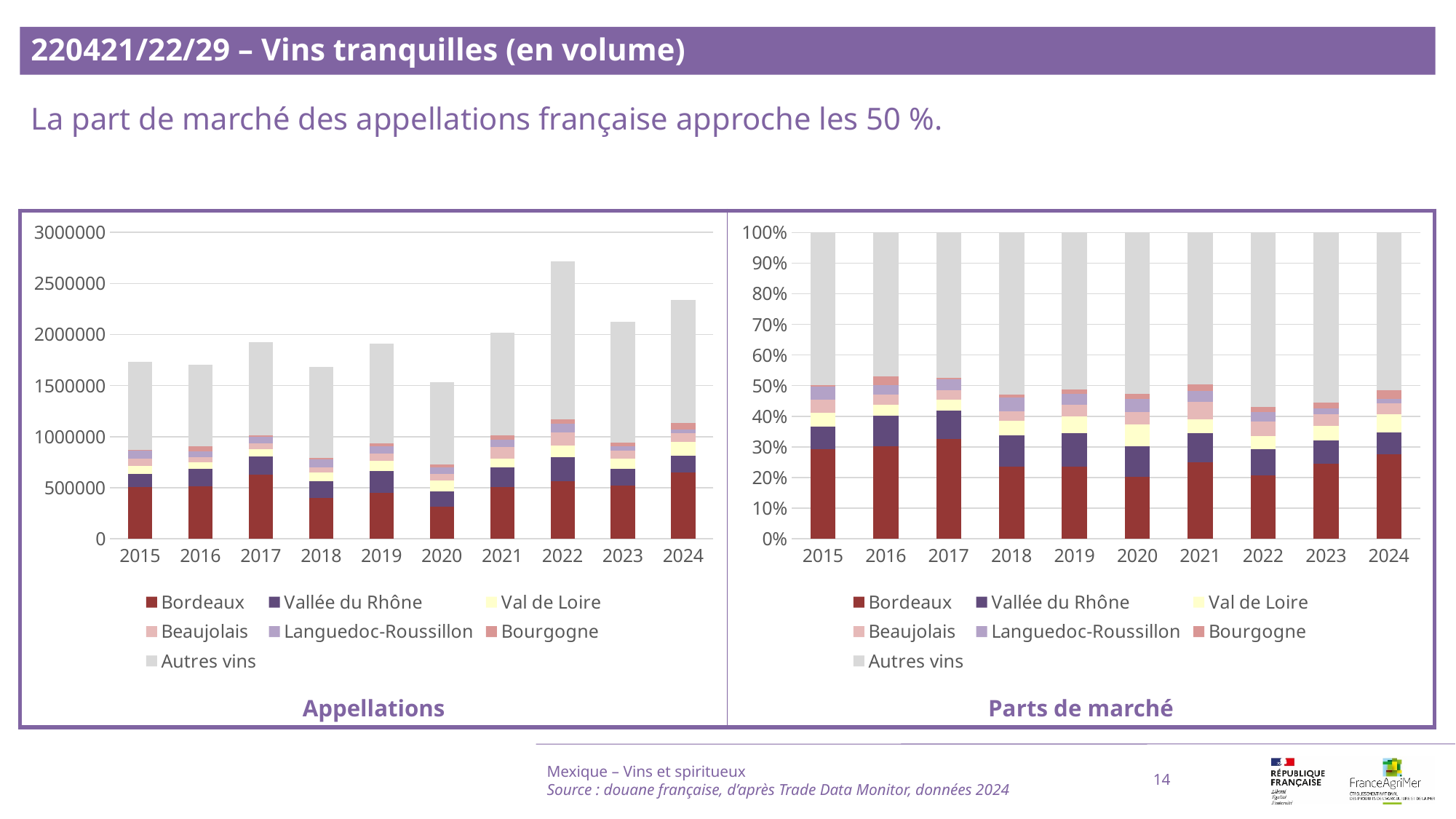
What is the title of the chart on the right of the slide? Parts de marché In the 'Appellations' chart, is the total bar for 2018 greater or less than 2000000? less In the 'Parts de marché' chart, is the Bordeaux share for 2017 greater or less than 30%? greater How many years are shown on the x axis of the 'Parts de marché' chart? 10 In the 'Parts de marché' chart, which series is shown in grey at the top of each bar? Autres vins In the 'Appellations' chart, which year has the tallest total bar? 2022 How many series does the legend of the 'Appellations' chart list? 7 In the 'Appellations' chart, which total bar is taller, 2022 or 2024? 2022 In the 'Appellations' chart, is the total bar for 2022 greater or less than 2500000? greater In the 'Appellations' chart, which year has the lowest total bar? 2020 What kind of chart is the 'Appellations' chart on the left? stacked bar chart In the 'Parts de marché' chart, what is the total of the stacked bar for 2015? 100%